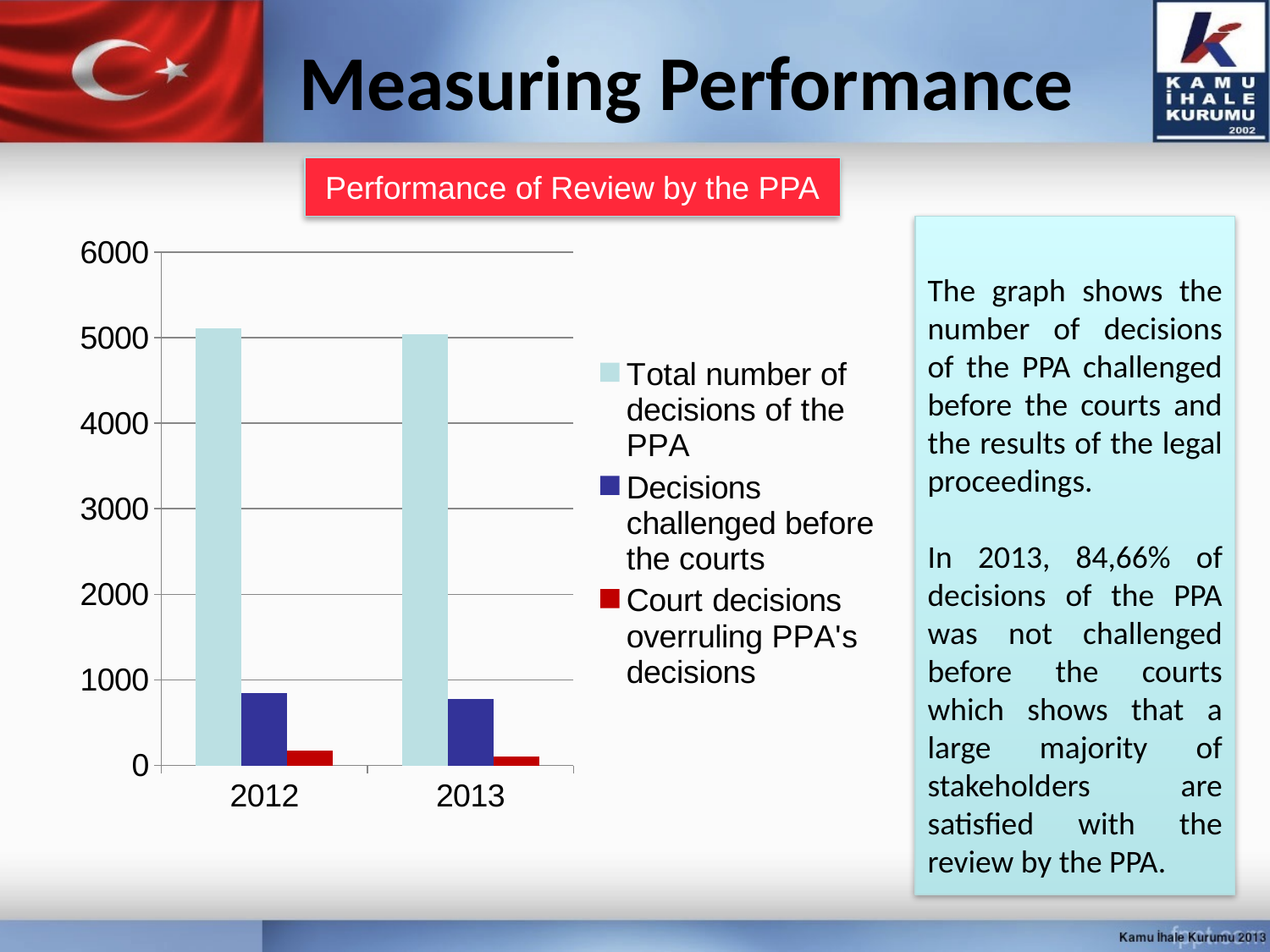
Is the total number of decisions of the PPA in 2012 greater or less than 5000? greater Is the number of decisions challenged before the courts in 2012 greater or less than 1000? less Which series has the highest value in 2012? Total number of decisions of the PPA What colour are the bars for the total number of decisions of the PPA? light blue Which series has the lowest value in 2013? Court decisions overruling PPA's decisions What kind of chart is shown on the slide? bar chart Is the total number of decisions of the PPA in 2013 greater or less than 6000? less Do court decisions overruling PPA's decisions rise or fall from 2012 to 2013? fall How many series does the chart legend list? 3 Which is larger in 2013: the total number of decisions of the PPA or the number of decisions challenged before the courts? Total number of decisions of the PPA How many years are shown on the x axis of the chart? 2